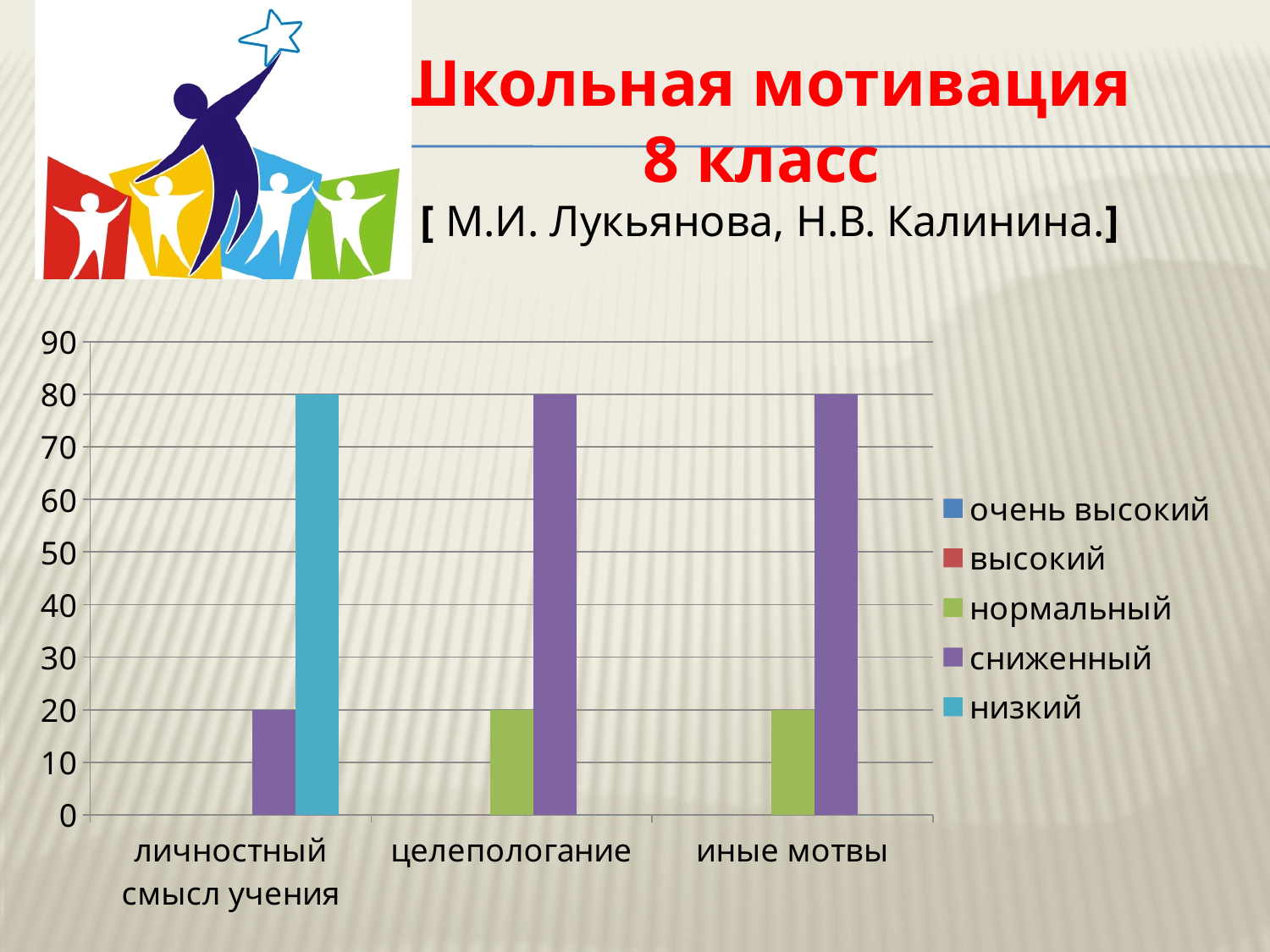
Is the value of the "сниженный" series for "иные мотвы" greater or less than 50? greater What is the value of the "низкий" series for "личностный смысл учения"? 80 What kind of chart is shown on the slide? bar chart How many categories are shown on the x axis of the chart? 3 Which legend entry is shown in light blue? низкий What is the value of the "сниженный" series for "личностный смысл учения"? 20 Which series has the highest value for "иные мотвы"? сниженный What is the difference between the "сниженный" and "нормальный" values for "целепологание"? 60 What is the value of the "нормальный" series for "иные мотвы"? 20 Which is larger for "личностный смысл учения": the "низкий" value or the "сниженный" value? низкий What is the value of the "сниженный" series for "целепологание"? 80 How many series does the chart legend list? 5